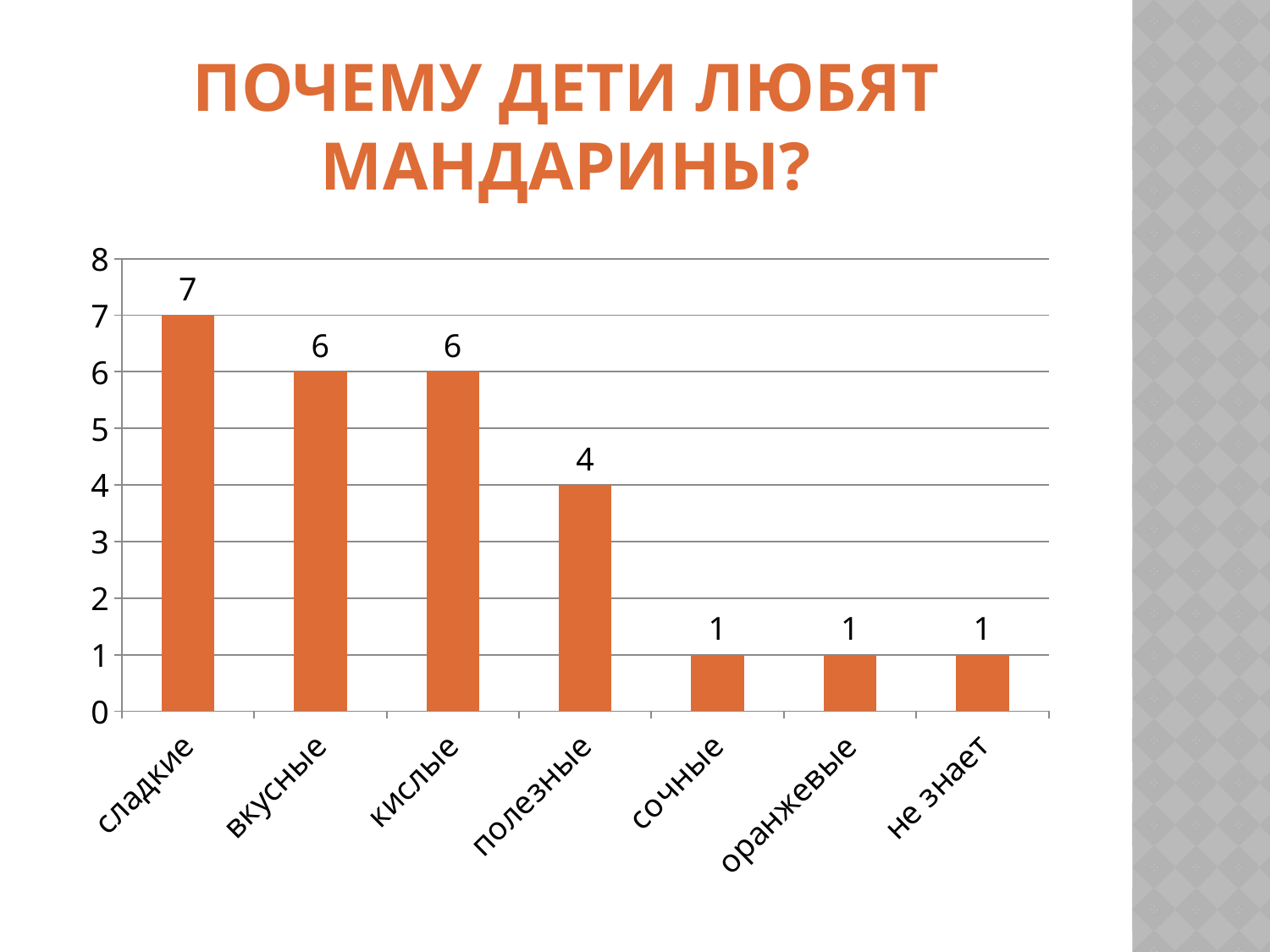
What kind of chart is shown on the slide? bar chart What is the value for сладкие? 7 Which category has the highest value? сладкие How many categories are shown on the x axis? 7 Is the value for полезные greater or less than 5? less Which is larger, the value for кислые or the value for полезные? кислые What is the value for полезные? 4 What is the value for оранжевые? 1 Do the values rise or fall from left to right along the x axis? fall What is the title of the slide? ПОЧЕМУ ДЕТИ ЛЮБЯТ МАНДАРИНЫ? What is the difference between the values for сладкие and полезные? 3 What is the difference between the values for вкусные and сочные? 5